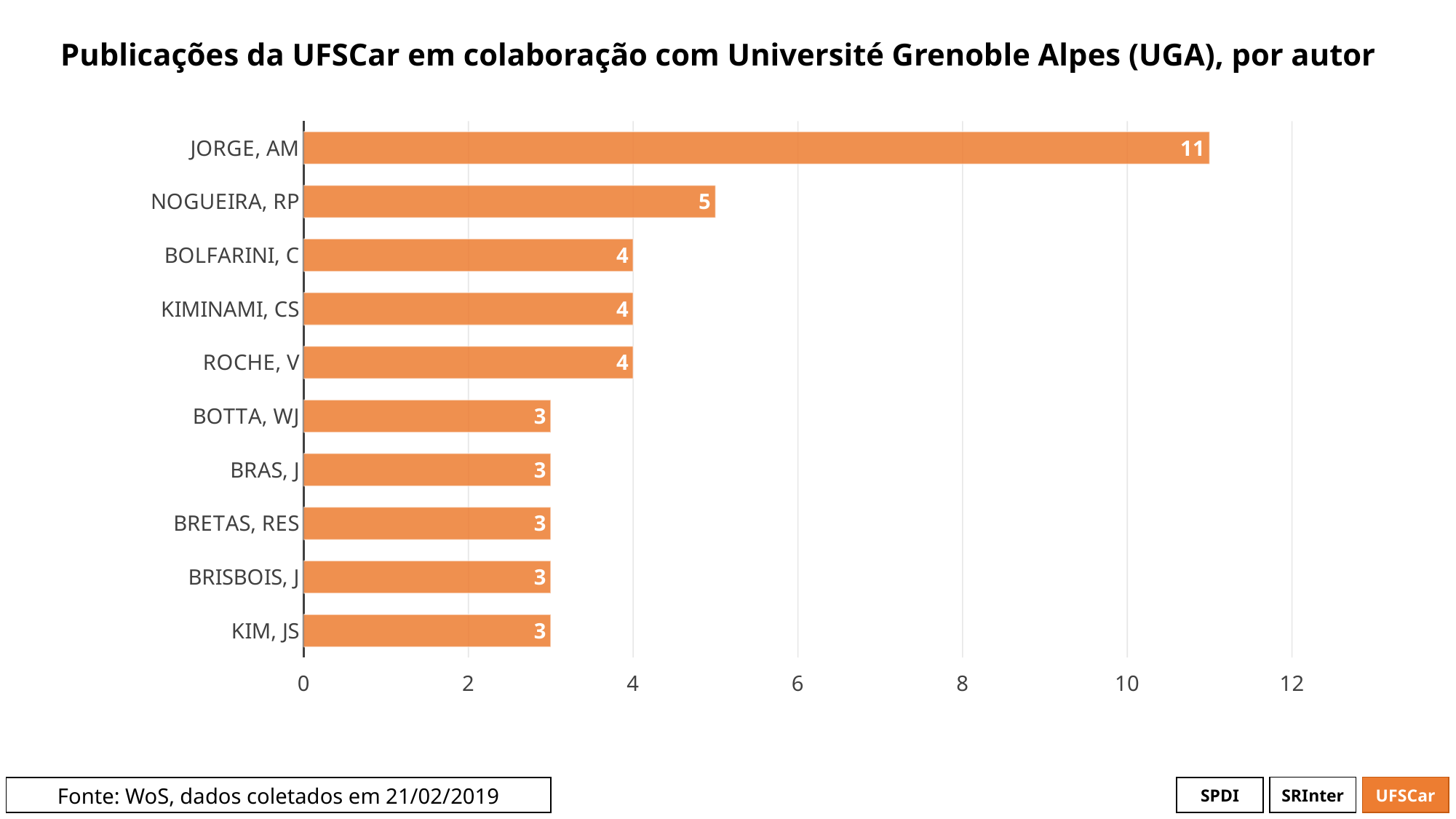
What is the value for NOGUEIRA, RP? 5 Is the value for JORGE, AM greater or less than 10? greater Which author has the highest number of publications? JORGE, AM What is the difference between the values for BOLFARINI, C and BOTTA, WJ? 1 What is the value for KIM, JS? 3 What is the difference between the values for JORGE, AM and NOGUEIRA, RP? 6 How many authors have a value of 3? 5 Which is larger, the value for NOGUEIRA, RP or the value for ROCHE, V? NOGUEIRA, RP How many publications does JORGE, AM have? 11 What kind of chart is shown on the slide? bar chart How many authors are shown in the chart? 10 What is the title of the chart? Publicações da UFSCar em colaboração com Université Grenoble Alpes (UGA), por autor